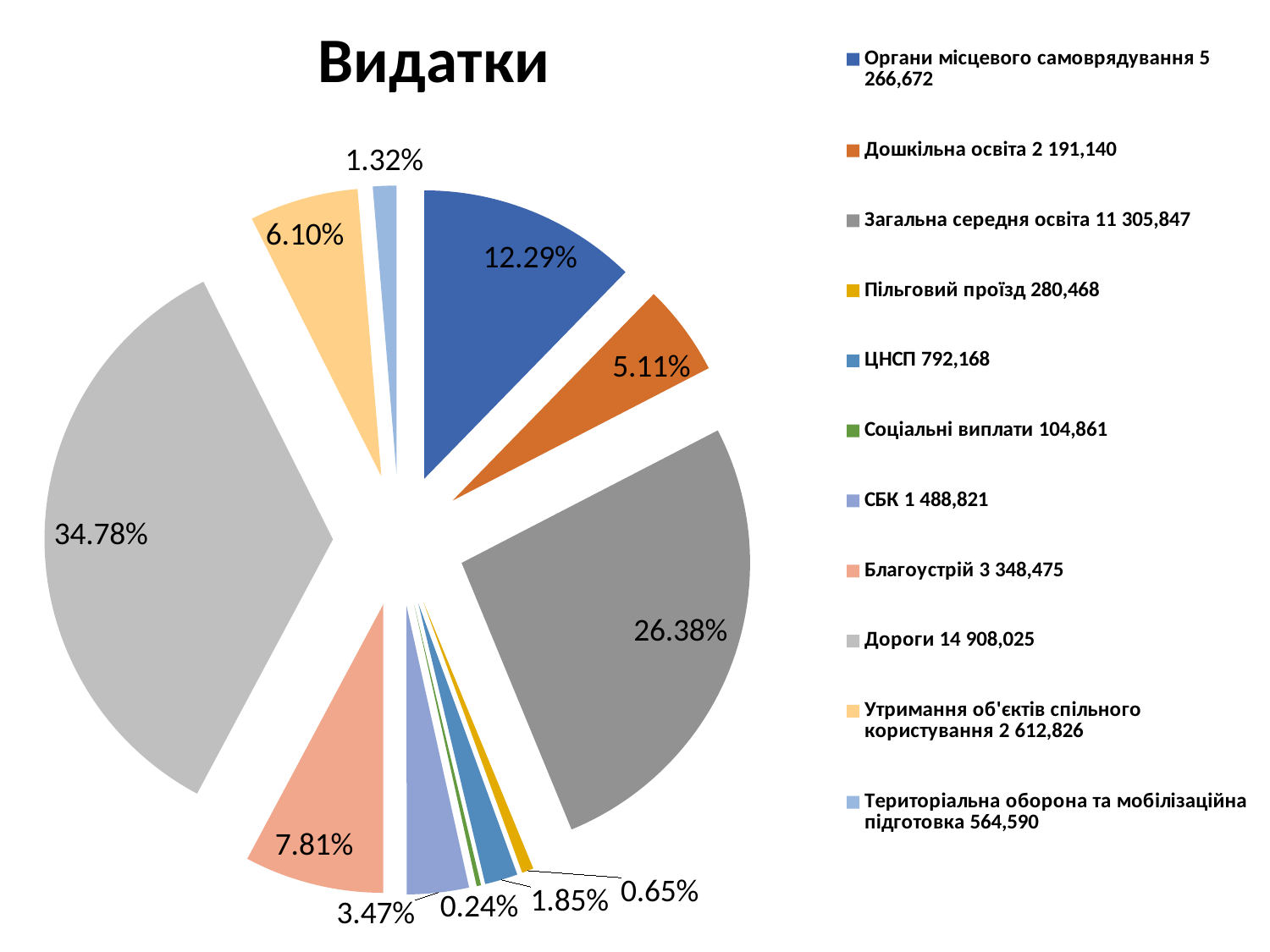
What share of the pie does Дороги account for? 34.78% What percentage is shown for Благоустрій? 7.81% Which is larger: the share for Дошкільна освіта or the share for Утримання об'єктів спільного користування? Утримання об'єктів спільного користування What kind of chart is shown on the slide? pie chart What is the difference in percentage points between Дороги and Загальна середня освіта? 8.40 What is the title of the chart? Видатки What value does the legend show for Дошкільна освіта? 2 191,140 What percentage is shown for Органи місцевого самоврядування? 12.29% How many categories does the legend of the pie chart list? 11 Which category has the smallest slice of the pie? Соціальні виплати Which category has the largest slice of the pie? Дороги What share of the pie does Загальна середня освіта account for? 26.38%